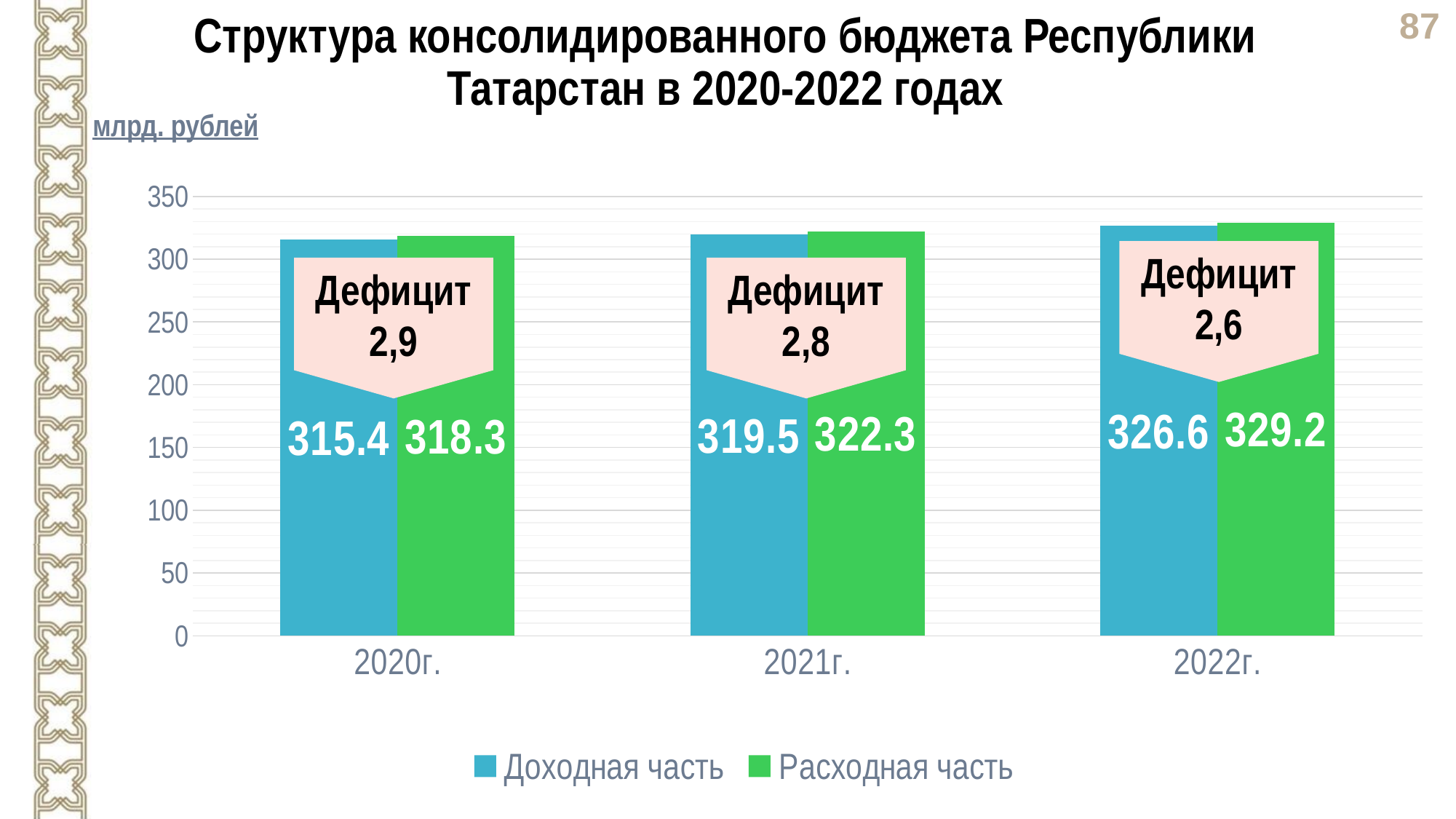
How many years (categories) are shown on the x axis? 3 Which year has the highest value of Доходная часть? 2022г. How many series does the legend list? 2 What deficit (Дефицит) is shown for 2021г.? 2,8 Which is larger in 2020г.: Доходная часть or Расходная часть? Расходная часть What is the value of Расходная часть for 2022г.? 329.2 Do the values of Доходная часть rise or fall from 2020г. to 2022г.? Rise What is the difference between Расходная часть and Доходная часть in 2022г.? 2.6 What is the value of Расходная часть for 2021г.? 322.3 Which year has the lowest value of Расходная часть? 2020г. What kind of chart is shown on the slide? Bar chart What is the value of Доходная часть for 2020г.? 315.4